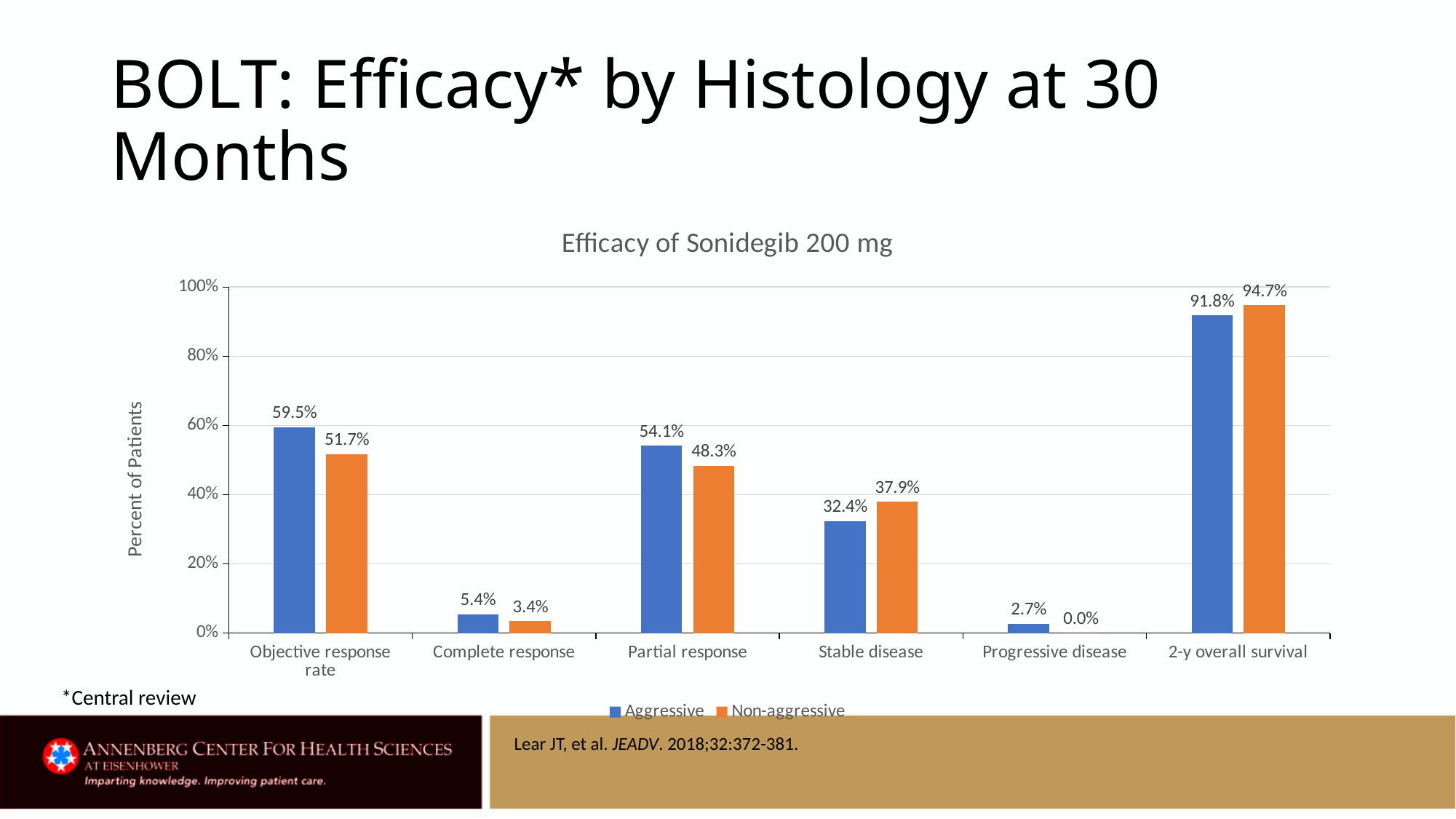
What is the title of the chart? Efficacy of Sonidegib 200 mg Which category has the highest Non-aggressive value? 2-y overall survival What is the Non-aggressive value for Progressive disease? 0.0% What is the difference between the Aggressive and Non-aggressive values for Partial response? 5.8% Which category has the lowest Aggressive value? Progressive disease Is the Aggressive value for 2-y overall survival greater or less than 80%? greater What kind of chart is shown? bar chart What is the Non-aggressive value for Stable disease? 37.9% For Stable disease, which series has the larger value, Aggressive or Non-aggressive? Non-aggressive What is the Aggressive value for Objective response rate? 59.5% How many series does the legend list? 2 How many categories are shown on the x axis? 6